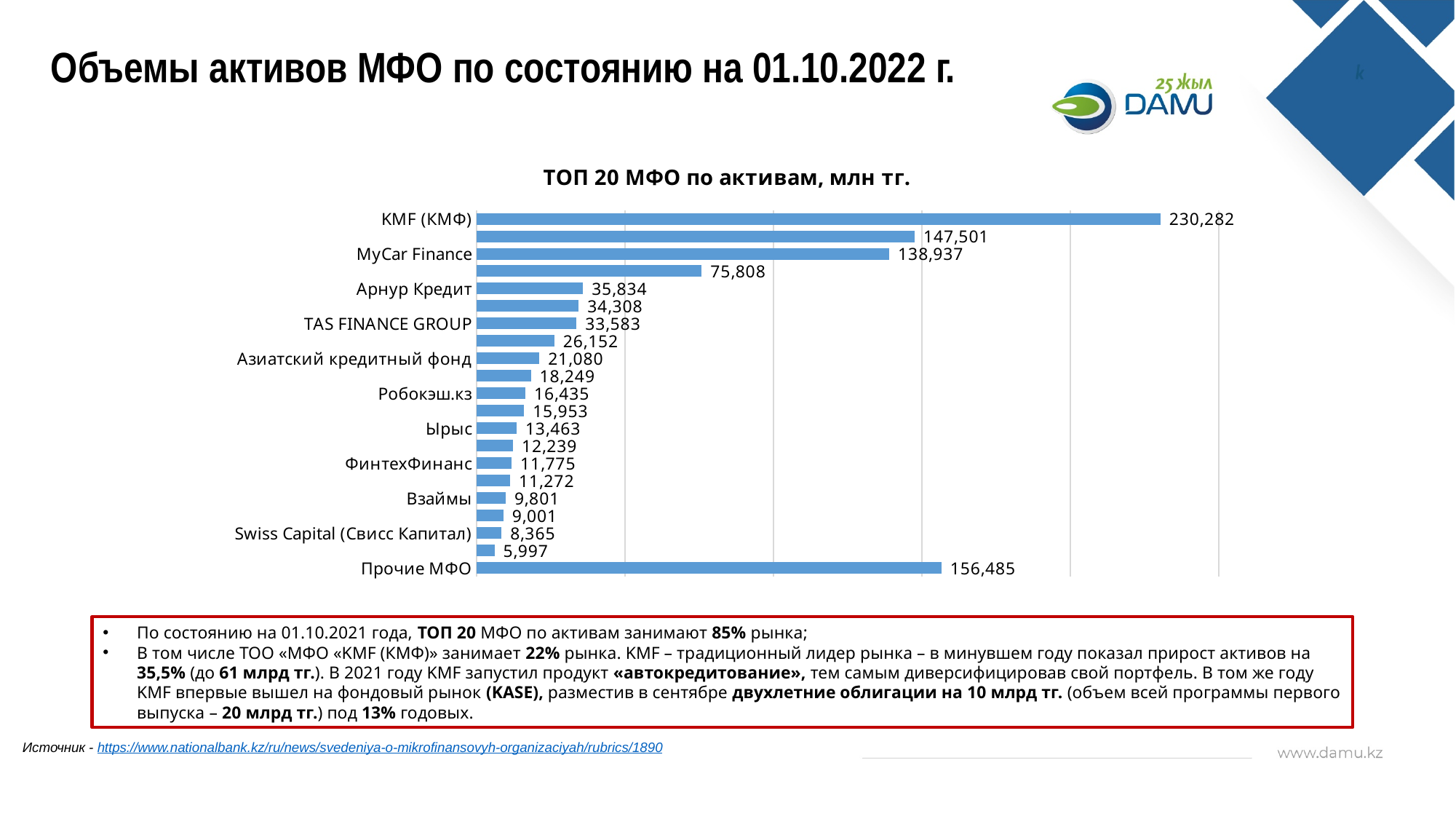
What is the value for Арнур Кредит? 35,834 What is the value for Swiss Capital (Свисс Капитал)? 8,365 Which is larger, the value for Арнур Кредит or the value for TAS FINANCE GROUP? Арнур Кредит What is the difference between the values for KMF (КМФ) and MyCar Finance? 91,345 What is the value for Азиатский кредитный фонд? 21,080 Which category has the highest value in the chart? KMF (КМФ) What is the value for KMF (КМФ) in the chart? 230,282 What is the value for TAS FINANCE GROUP? 33,583 What kind of chart is shown on the slide? Bar chart What is the value for MyCar Finance? 138,937 What is the title of the chart? ТОП 20 МФО по активам, млн тг. What is the value for Прочие МФО? 156,485